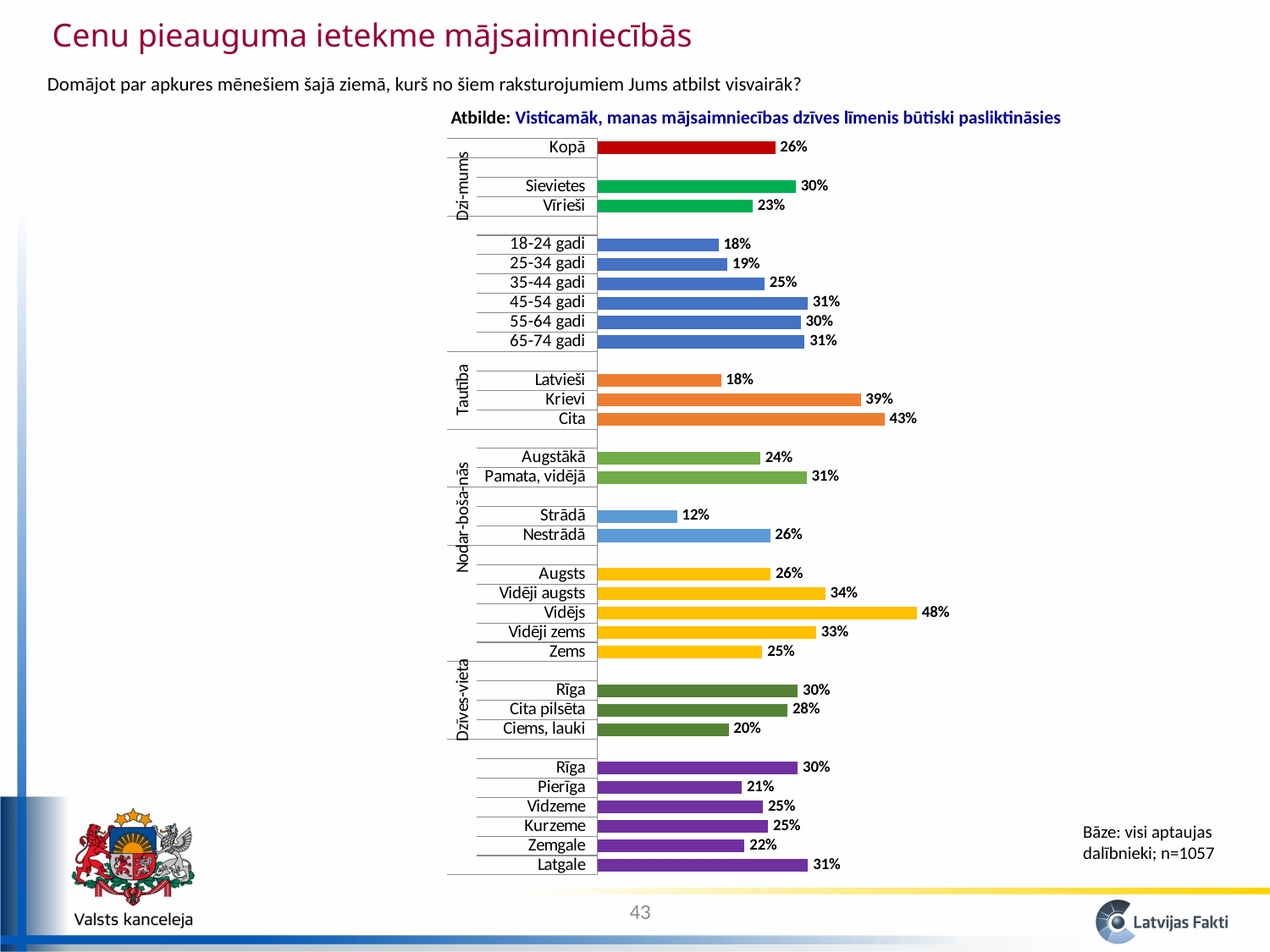
What is the value for Zemgale? 22% What is the difference between the values for Sievietes and Vīrieši? 7% What is the difference between the values for Cita and Latvieši? 25% What is the value for Kopā? 26% Which category has the lowest value in the chart? Strādā Which is larger, the value for Ciems, lauki or the value for Cita pilsēta? Cita pilsēta What is the value for Strādā? 12% What is the value for Krievi? 39% Which is larger, the value for Pamata, vidējā or the value for Augstākā? Pamata, vidējā Which category has the highest value in the chart? Vidējs What is the value for Latgale? 31% What kind of chart is shown on the slide? Bar chart